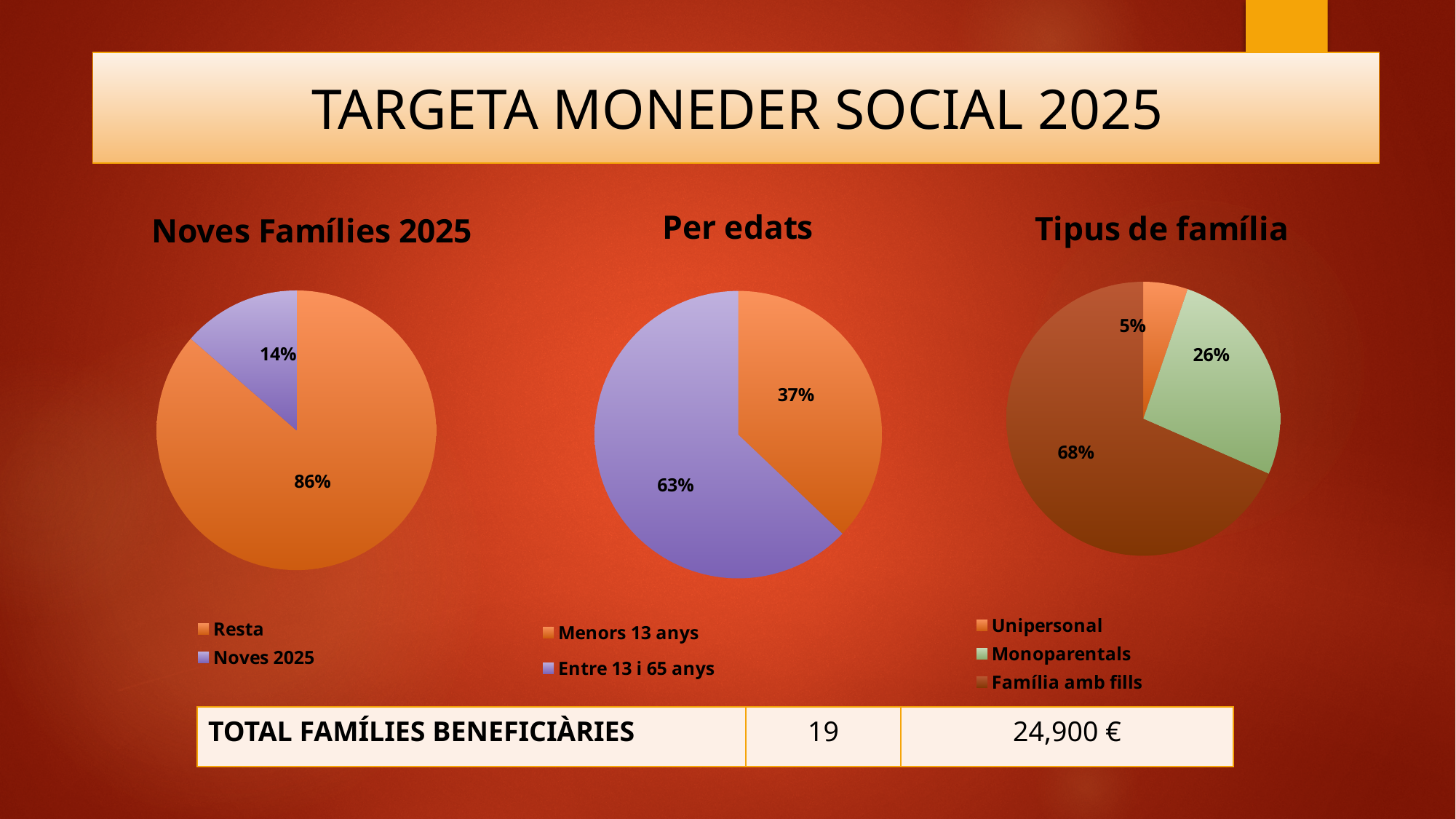
In the 'Per edats' chart, what is the difference between 'Entre 13 i 65 anys' and 'Menors 13 anys'? 26% In the 'Per edats' chart, what is the value for 'Menors 13 anys'? 37% In the 'Per edats' chart, which category is the largest? Entre 13 i 65 anys In the 'Tipus de família' chart, how many categories are shown? 3 In the 'Noves Famílies 2025' chart, what share of the pie is 'Noves 2025'? 14% How many entries does the legend of the 'Noves Famílies 2025' chart list? 2 In the 'Tipus de família' chart, what is the value for 'Monoparentals'? 26% In the 'Tipus de família' chart, which is larger, 'Monoparentals' or 'Unipersonal'? Monoparentals In the 'Noves Famílies 2025' chart, what is the value for 'Resta'? 86% In the 'Tipus de família' chart, which category is the largest? Família amb fills What kind of chart is the 'Per edats' chart? Pie chart In the 'Tipus de família' chart, which category is the smallest? Unipersonal